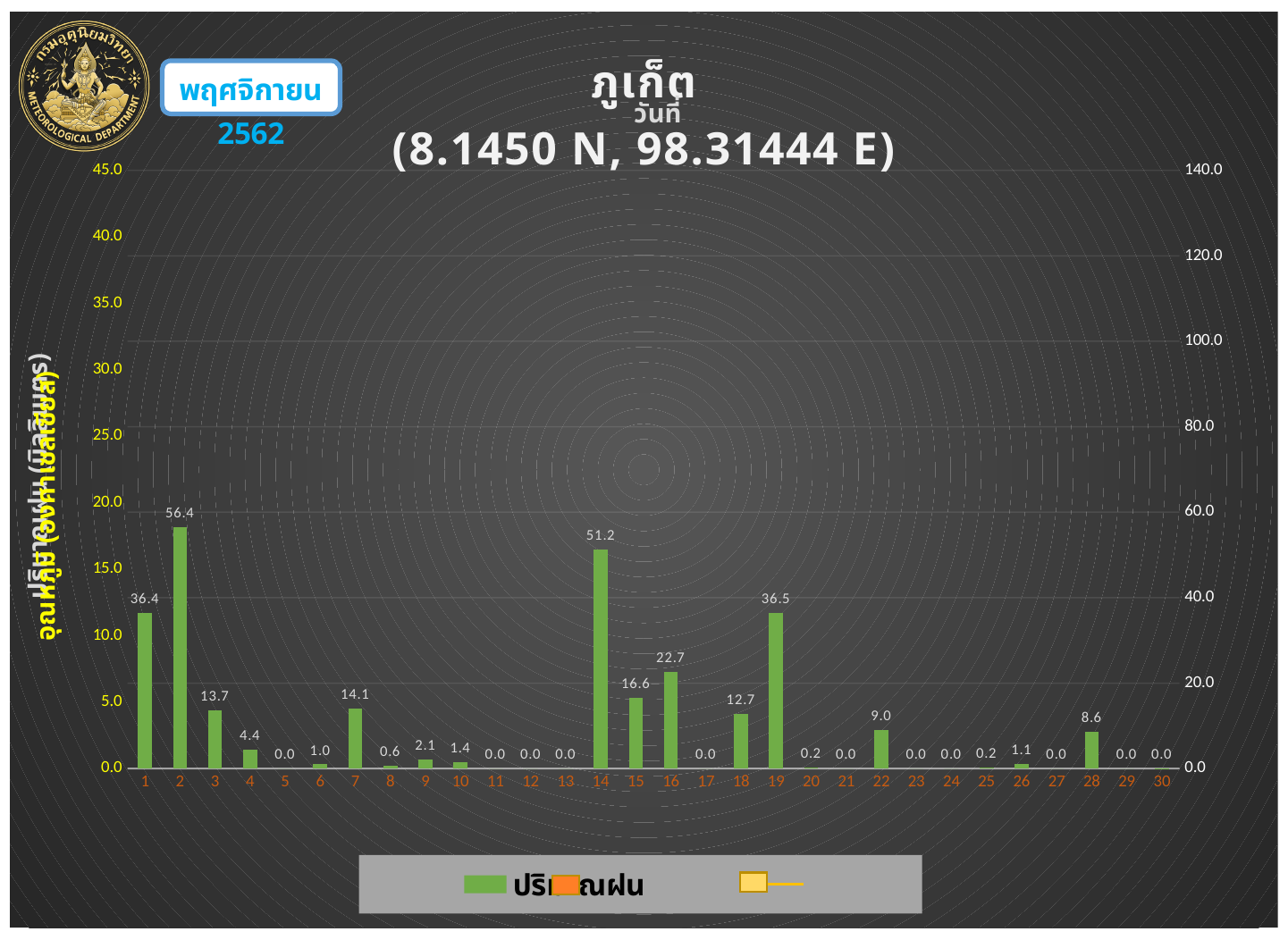
Which has a larger rainfall value, day 1 or day 3? day 1 Which day has the highest rainfall value? 2 How many days are shown on the x axis of the chart? 30 What is the rainfall value shown for day 14? 51.2 What kind of chart is shown on the slide? bar chart Which has a larger rainfall value, day 7 or day 18? day 7 What is the rainfall value shown for day 28? 8.6 What coordinates are given in the chart title? 8.1450 N, 98.31444 E What is the rainfall value shown for day 2? 56.4 What is the difference between the rainfall values for day 2 and day 14? 5.2 What is the difference between the rainfall values for day 16 and day 15? 6.1 What is the rainfall value shown for day 19? 36.5